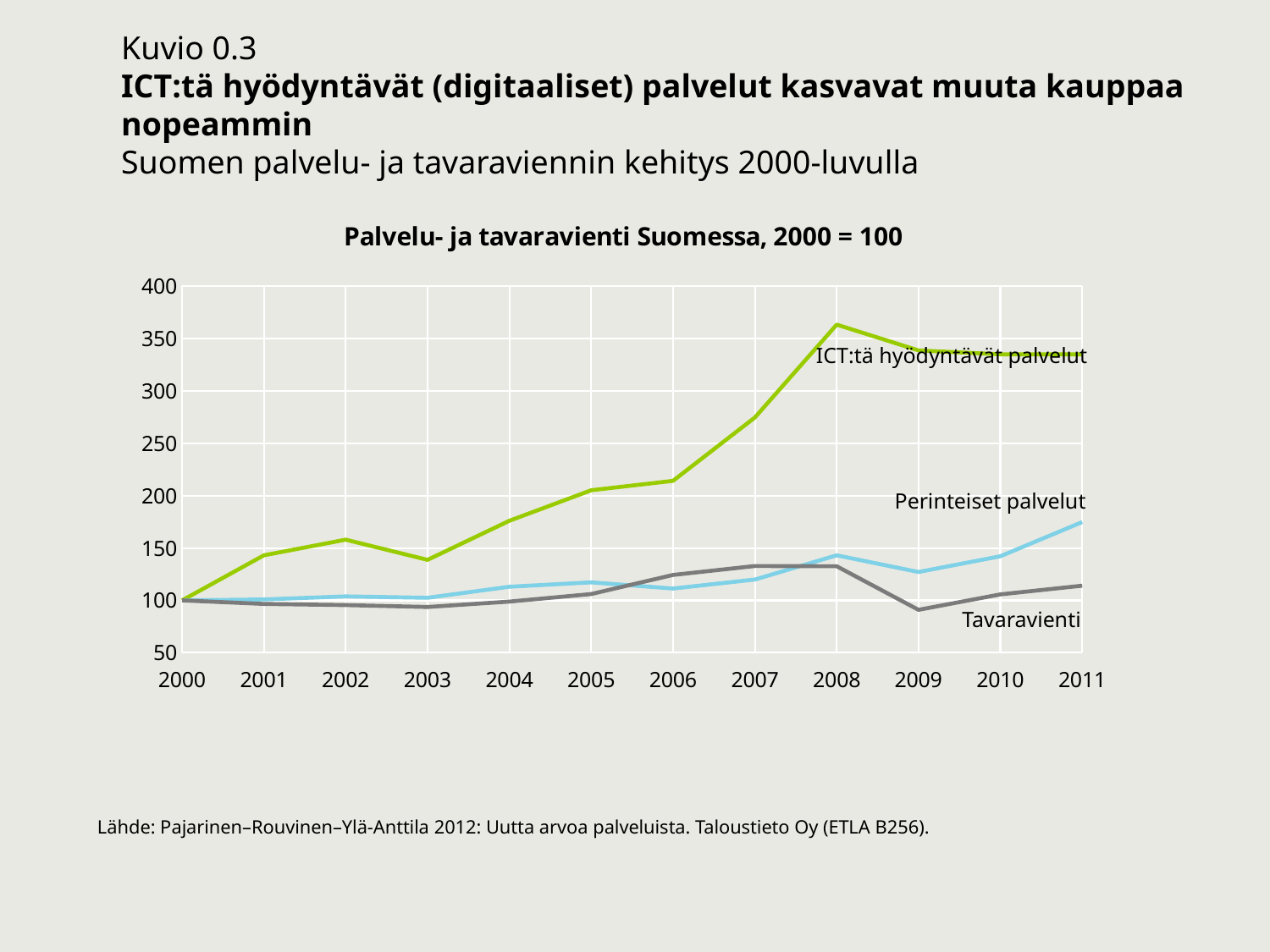
In which year does ICT:tä hyödyntävät palvelut reach its highest value? 2008 What is the title of the chart? Palvelu- ja tavaravienti Suomessa, 2000 = 100 Is the value for Tavaravienti in 2009 greater or less than 100? less What kind of chart is shown on the slide? line chart Is the value for Perinteiset palvelut in 2011 greater or less than 150? greater Is the value for ICT:tä hyödyntävät palvelut in 2008 greater or less than 350? greater How many years are shown on the x axis of the chart? 12 In which year is Tavaravienti at its lowest value? 2009 Does the ICT:tä hyödyntävät palvelut series rise or fall between 2000 and 2008? rise What is the value of ICT:tä hyödyntävät palvelut in 2000? 100 Which series has the highest value in 2011? ICT:tä hyödyntävät palvelut How many series are plotted in the chart? 3